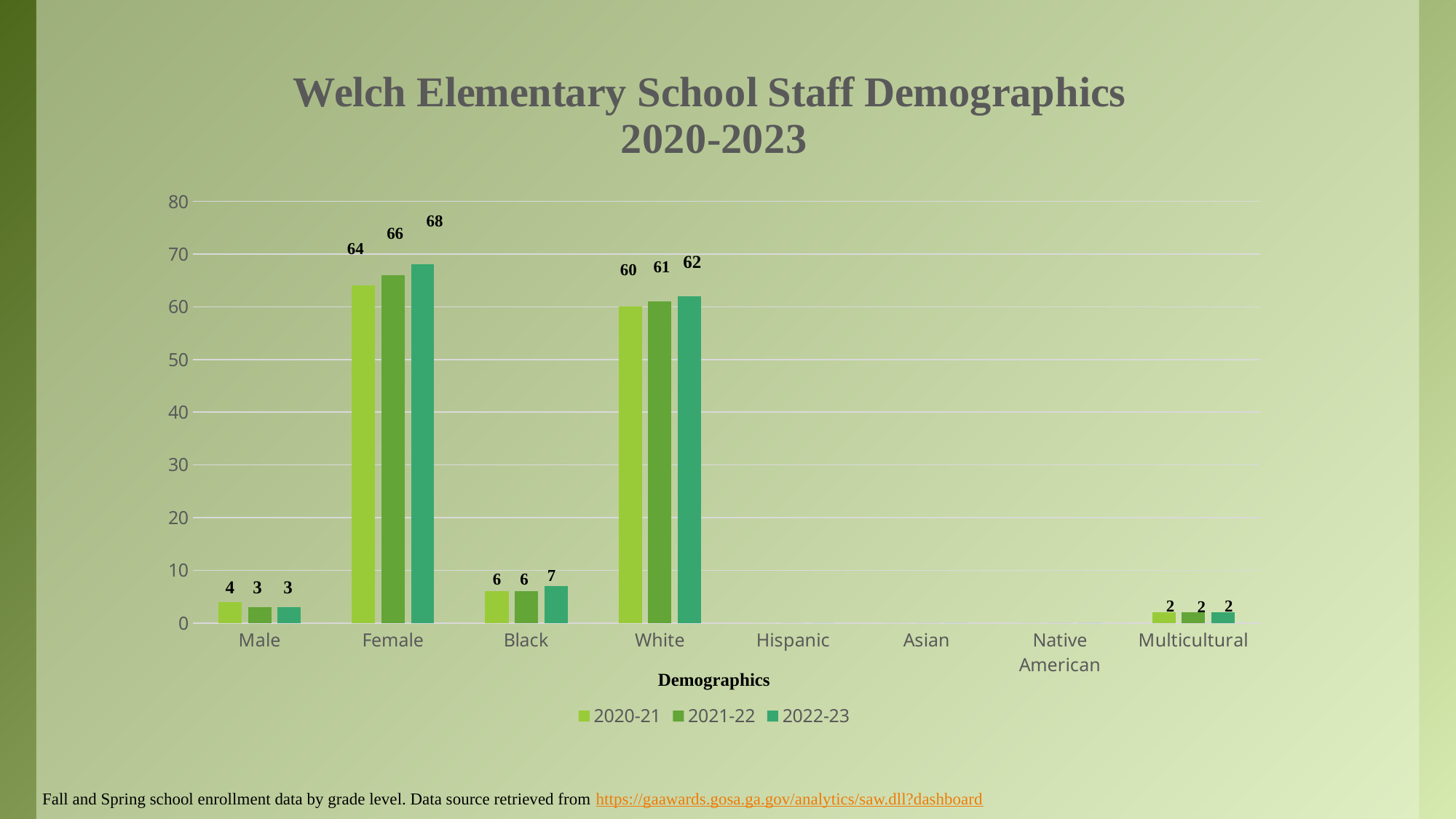
What kind of chart is shown on the slide? bar chart Do the Female values rise or fall from 2020-21 to 2022-23? rise What is the value for Male in 2020-21? 4 What is the title of the chart? Welch Elementary School Staff Demographics 2020-2023 What is the value for Black in 2022-23? 7 What is the value for Female in 2022-23? 68 Which category has the highest value in the 2021-22 series? Female How many categories are shown on the x axis? 8 How many series does the legend list? 3 What is the value for White in 2020-21? 60 What is the difference between the Female and White values in 2020-21? 4 Which is larger, the 2022-23 value for Female or the 2022-23 value for White? Female